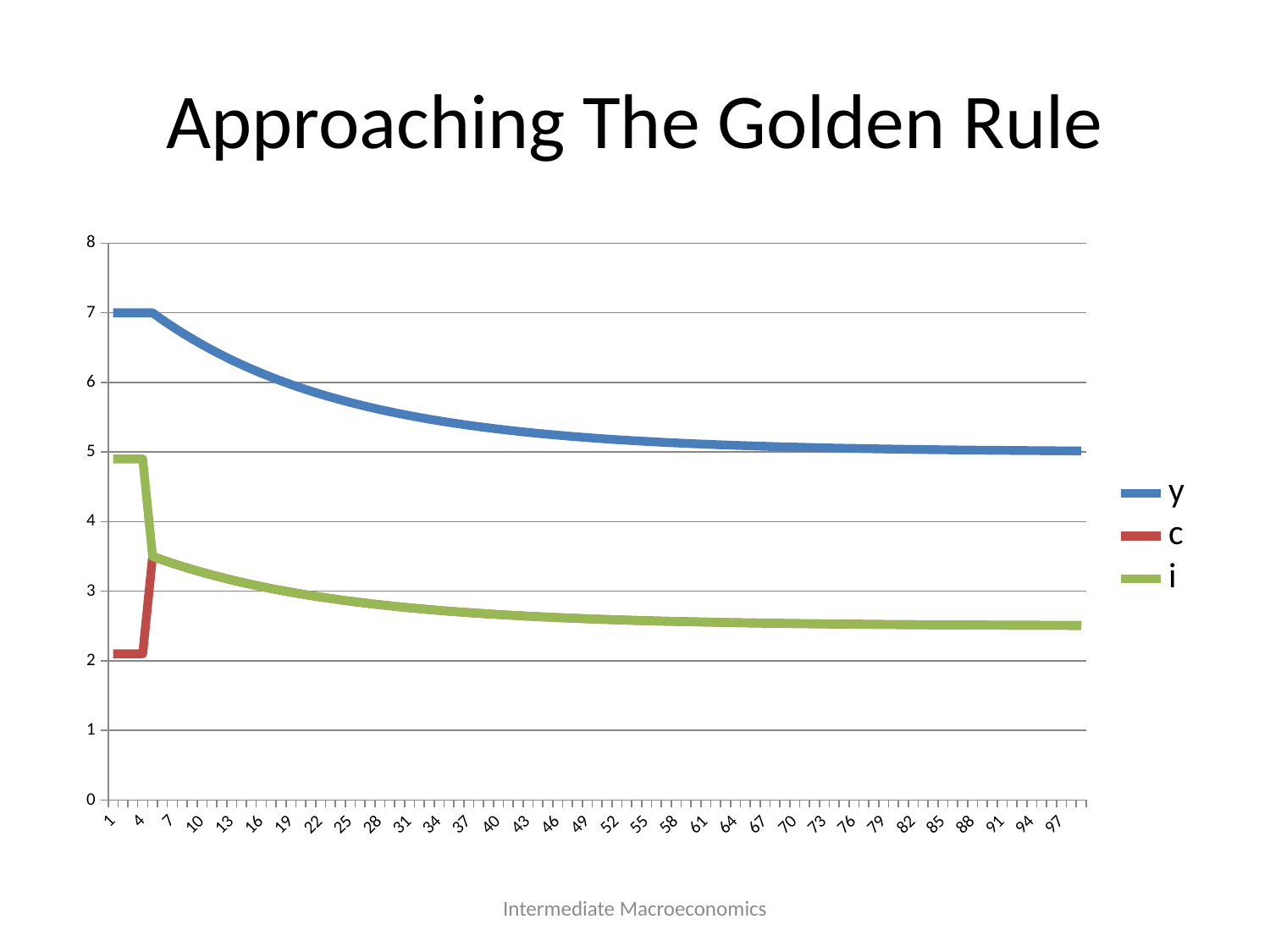
What is the title of the chart? Approaching The Golden Rule What kind of chart is shown on the slide? line chart Is the value of c at x = 1 greater or less than 3? less At x = 1, which is larger, y or i? y What is the value of y at x = 1? 7 Is the value of i at x = 1 greater or less than 4? greater Does the y series rise or fall as the x axis increases? fall Does the i series rise or fall as the x axis increases? fall What are the series names listed in the legend? y, c, i Which series has the lowest value at x = 1? c Is the value of y at x = 97 greater or less than 6? less How many series does the legend list? 3